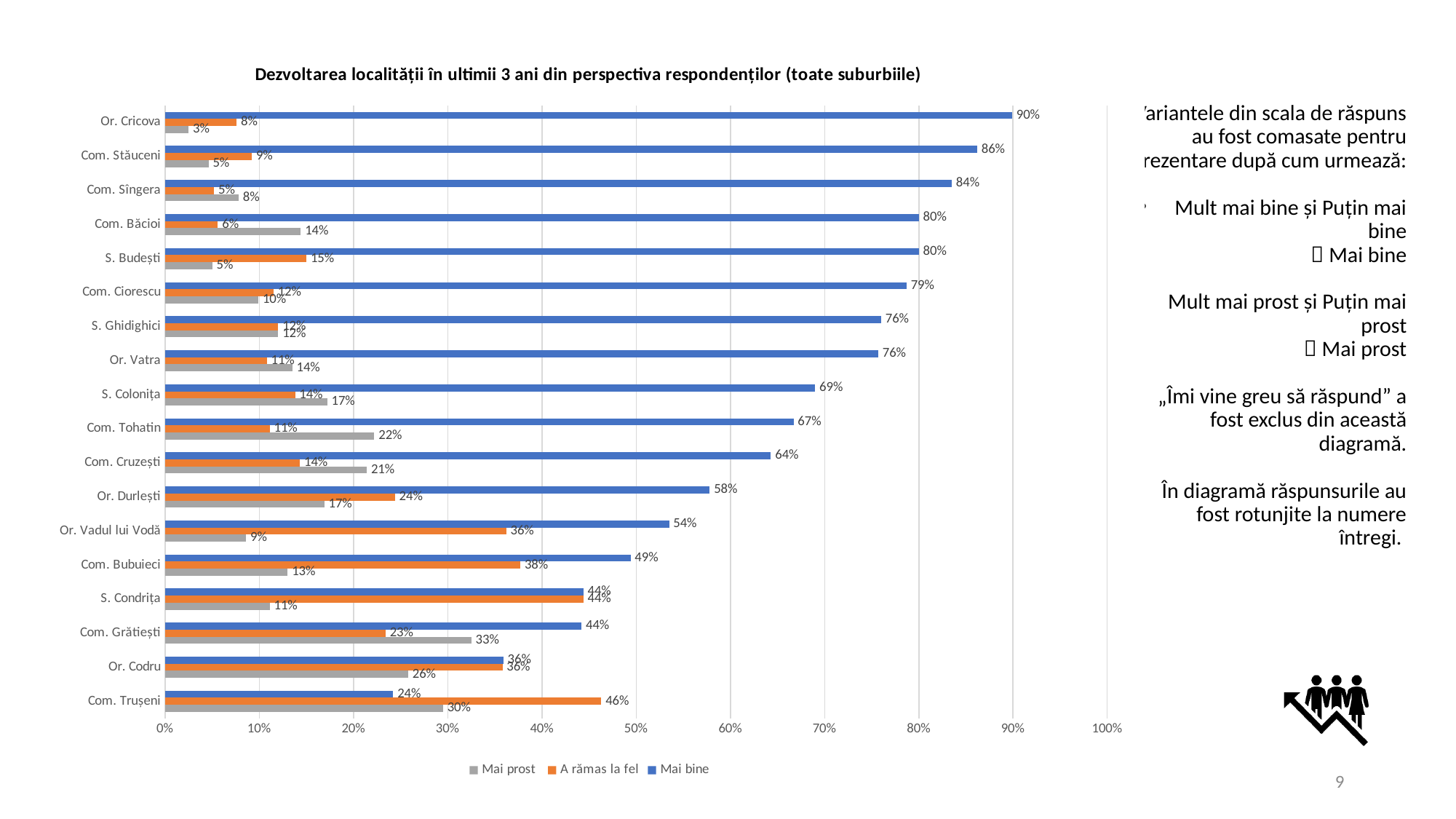
How many series does the legend list? 3 What is the 'A rămas la fel' value for Com. Trușeni? 46% What is the difference between the 'Mai bine' values for Or. Cricova and Com. Stăuceni? 4% What type of chart is shown on the slide? Bar chart Which locality has the highest 'Mai bine' value? Or. Cricova What is the 'Mai prost' value for Com. Grătiești? 33% Which locality has the lowest 'Mai bine' value? Com. Trușeni How many localities are shown on the chart? 18 Is the 'Mai bine' value for Or. Durlești greater or less than 50%? greater Which is larger for Com. Bubuieci: 'Mai bine' or 'A rămas la fel'? Mai bine What is the 'Mai bine' value for Or. Cricova? 90% Which series is shown in orange in the legend? A rămas la fel